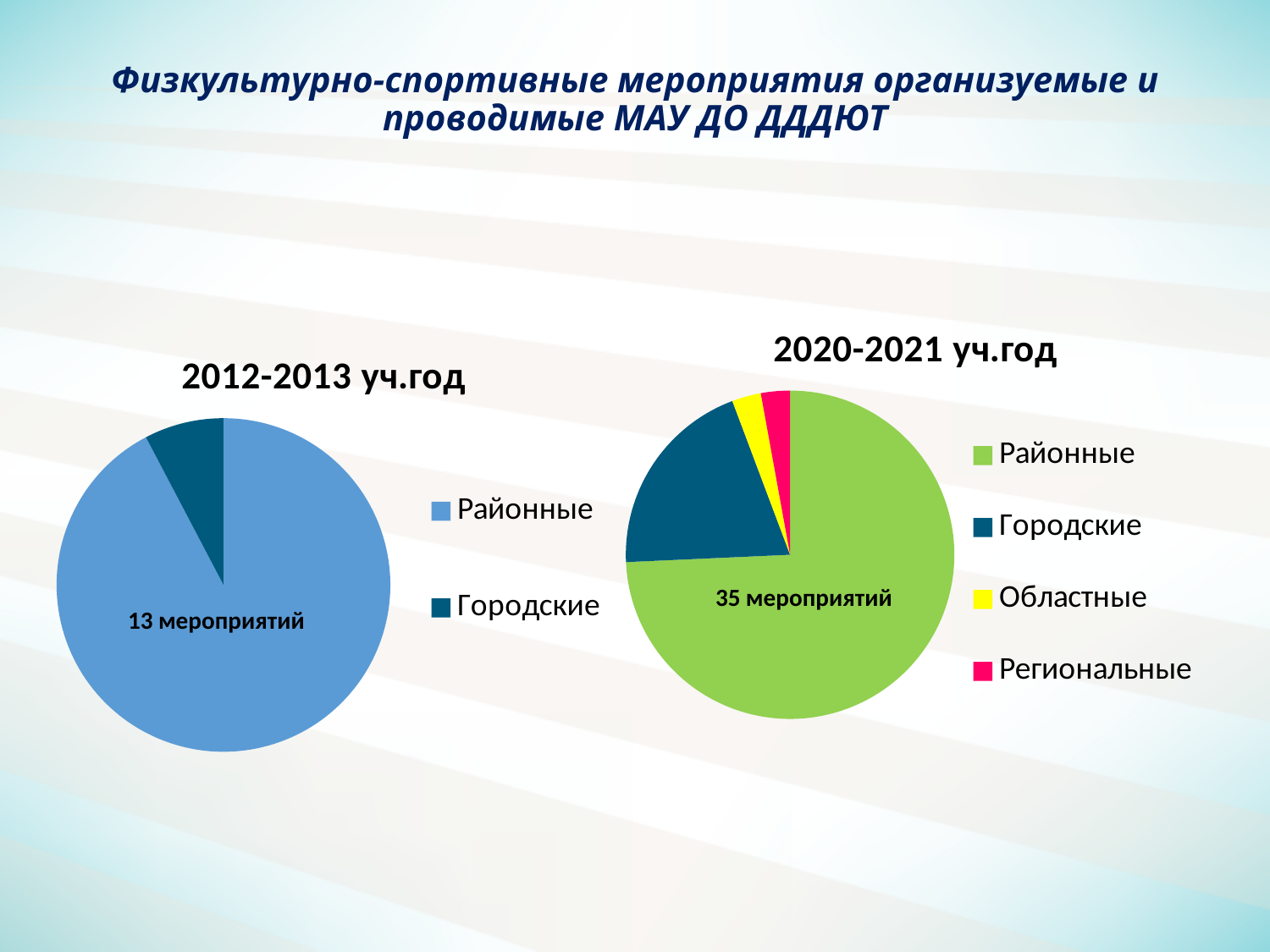
In the 2020-2021 уч.год chart, which slice is larger, Городские or Областные? Городские In the 2020-2021 уч.год chart, which slice is larger, Районные or Городские? Районные In the 2020-2021 уч.год chart, which category has the largest slice? Районные In the 2020-2021 уч.год chart, what colour is the Областные slice? yellow What type of chart is used for the 2020-2021 уч.год data? pie chart In the 2020-2021 уч.год chart, how many categories does the legend list? 4 What type of chart is used for the 2012-2013 уч.год data? pie chart What total number of events is printed on the 2012-2013 уч.год chart? 13 мероприятий In the 2012-2013 уч.год chart, how many categories does the legend list? 2 In the 2012-2013 уч.год chart, which category has the smallest slice? Городские What total number of events is printed on the 2020-2021 уч.год chart? 35 мероприятий In the 2012-2013 уч.год chart, which category has the largest slice? Районные